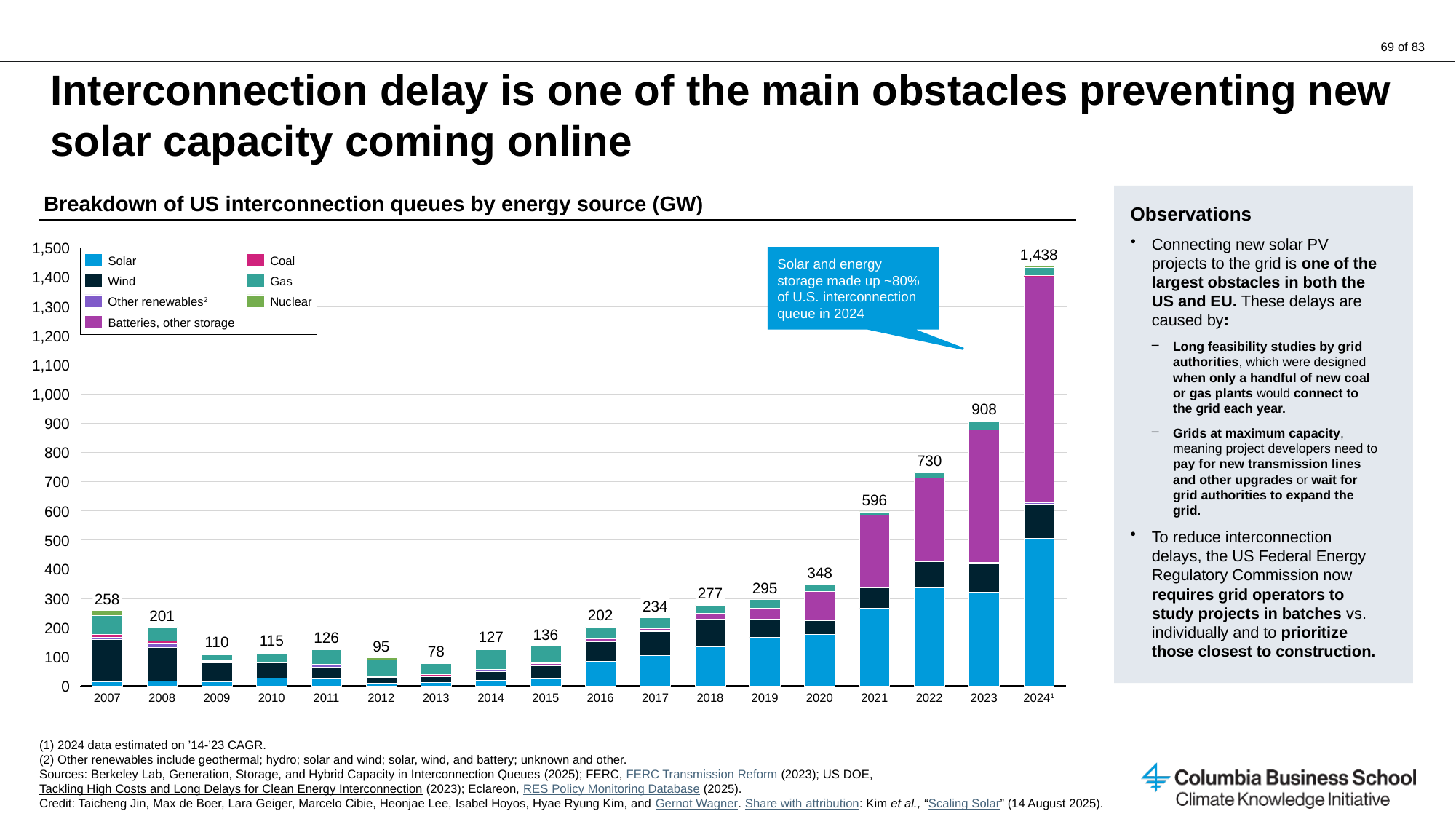
What is the total value labeled for 2023? 908 Which year has the lowest total interconnection queue? 2013 What is the total value labeled for 2007? 258 How many years are shown on the x axis? 18 Which year has the highest total interconnection queue? 2024 What is the difference between the 2007 total and the 2008 total? 57 What is the total interconnection queue value shown for 2024? 1,438 Which is larger, the total for 2021 or the total for 2020? 2021 What is the difference between the 2024 total and the 2023 total? 530 How many energy sources does the legend list? 7 What kind of chart is used to show the breakdown of US interconnection queues? Stacked bar chart Is the Solar segment for 2023 greater or less than 300? greater